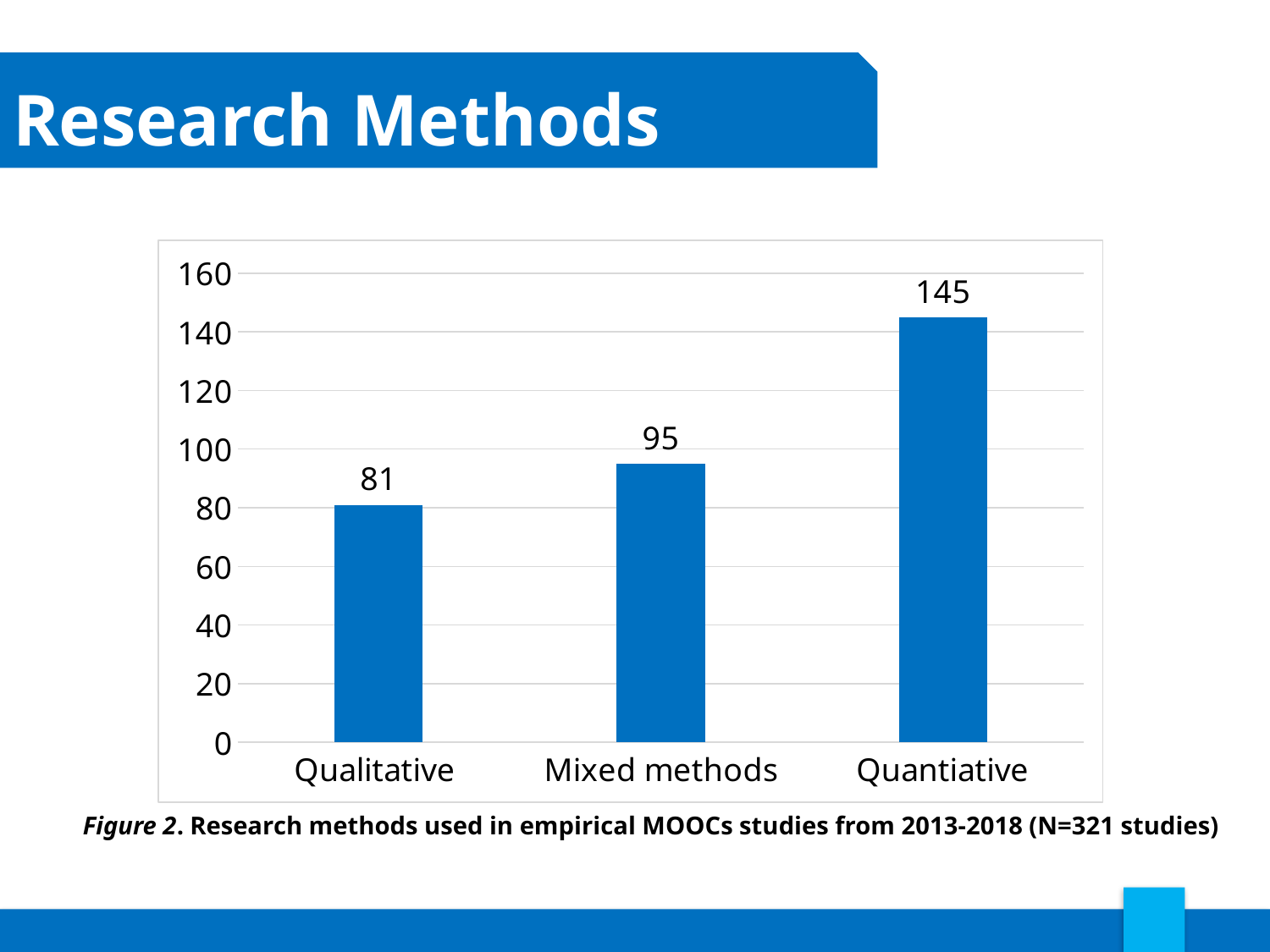
What is the value for Quantiative? 145 Which research method has the highest value? Quantiative How many categories are shown on the x axis? 3 What is the difference between the values for Quantiative and Qualitative? 64 Which is larger, the value for Mixed methods or the value for Qualitative? Mixed methods Is the value for Quantiative greater or less than 140? greater What kind of chart is shown on the slide? bar chart What is the difference between the values for Mixed methods and Qualitative? 14 Do the values rise or fall from left to right along the x axis? rise Which research method has the lowest value? Qualitative What is the value for Qualitative? 81 What is the value for Mixed methods? 95